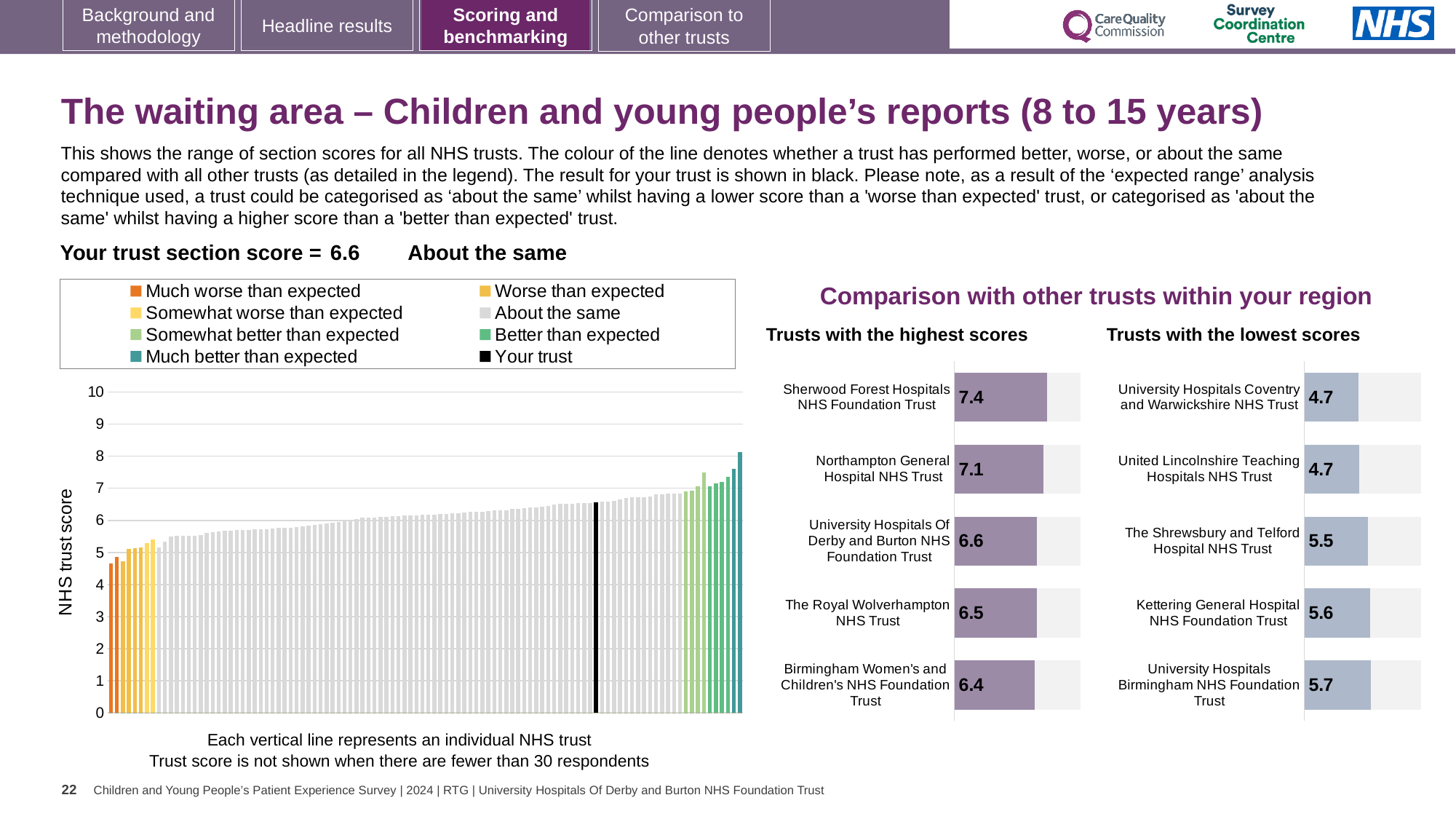
In the 'Trusts with the lowest scores' chart, which has the larger score: Kettering General Hospital NHS Foundation Trust or The Shrewsbury and Telford Hospital NHS Trust? Kettering General Hospital NHS Foundation Trust In the 'Trusts with the highest scores' chart, how many trusts are shown? 5 In the 'Trusts with the highest scores' chart, what is the difference between the scores of Sherwood Forest Hospitals NHS Foundation Trust and Birmingham Women's and Children's NHS Foundation Trust? 1.0 In the large chart on the left, do the bar values rise or fall from left to right along the x axis? rise In the large chart on the left, how many entries does the legend list? 8 In the large chart on the left, what is the label on the vertical axis? NHS trust score In the 'Trusts with the highest scores' chart, what is the score for Sherwood Forest Hospitals NHS Foundation Trust? 7.4 In the 'Trusts with the lowest scores' chart, what is the score for The Shrewsbury and Telford Hospital NHS Trust? 5.5 In the large chart on the left, is the value of the leftmost (lowest) bar greater or less than 5? less In the 'Trusts with the lowest scores' chart, which trust has the highest score? University Hospitals Birmingham NHS Foundation Trust In the large chart on the left, what is the score of the black bar representing your trust? 6.6 What kind of chart is the large chart on the left showing NHS trust scores? bar chart